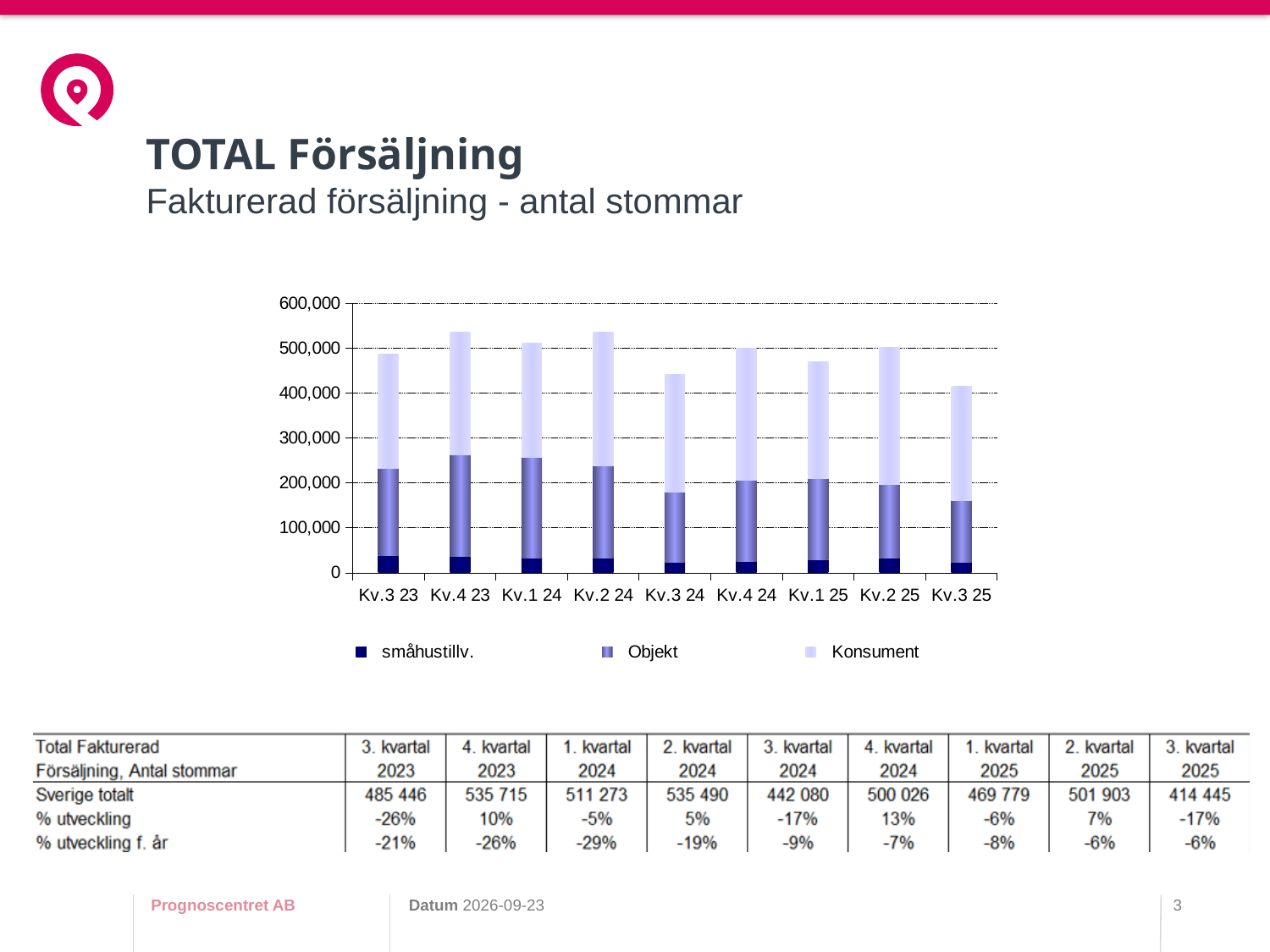
How many quarters (categories) are shown on the x axis of the chart? 9 Is the total stacked bar for Kv.3 24 greater or less than 500,000? less Which total bar is taller, Kv.3 24 or Kv.4 24? Kv.4 24 According to the table below the chart, what is the total (Sverige totalt) for the Kv.3 25 bar? 414 445 How many series does the chart legend list? 3 Which series are listed in the chart legend? småhustillv., Objekt, Konsument Is the total stacked bar for Kv.4 23 greater or less than 500,000? greater Is the total stacked bar for Kv.3 25 greater or less than 500,000? less What kind of chart is shown on the slide? Stacked bar chart Which quarter has the lowest total stacked bar? Kv.3 25 Using the totals in the table, what is the difference between the Kv.4 23 total and the Kv.3 23 total? 50 269 What is the subtitle of the chart slide under 'TOTAL Försäljning'? Fakturerad försäljning - antal stommar